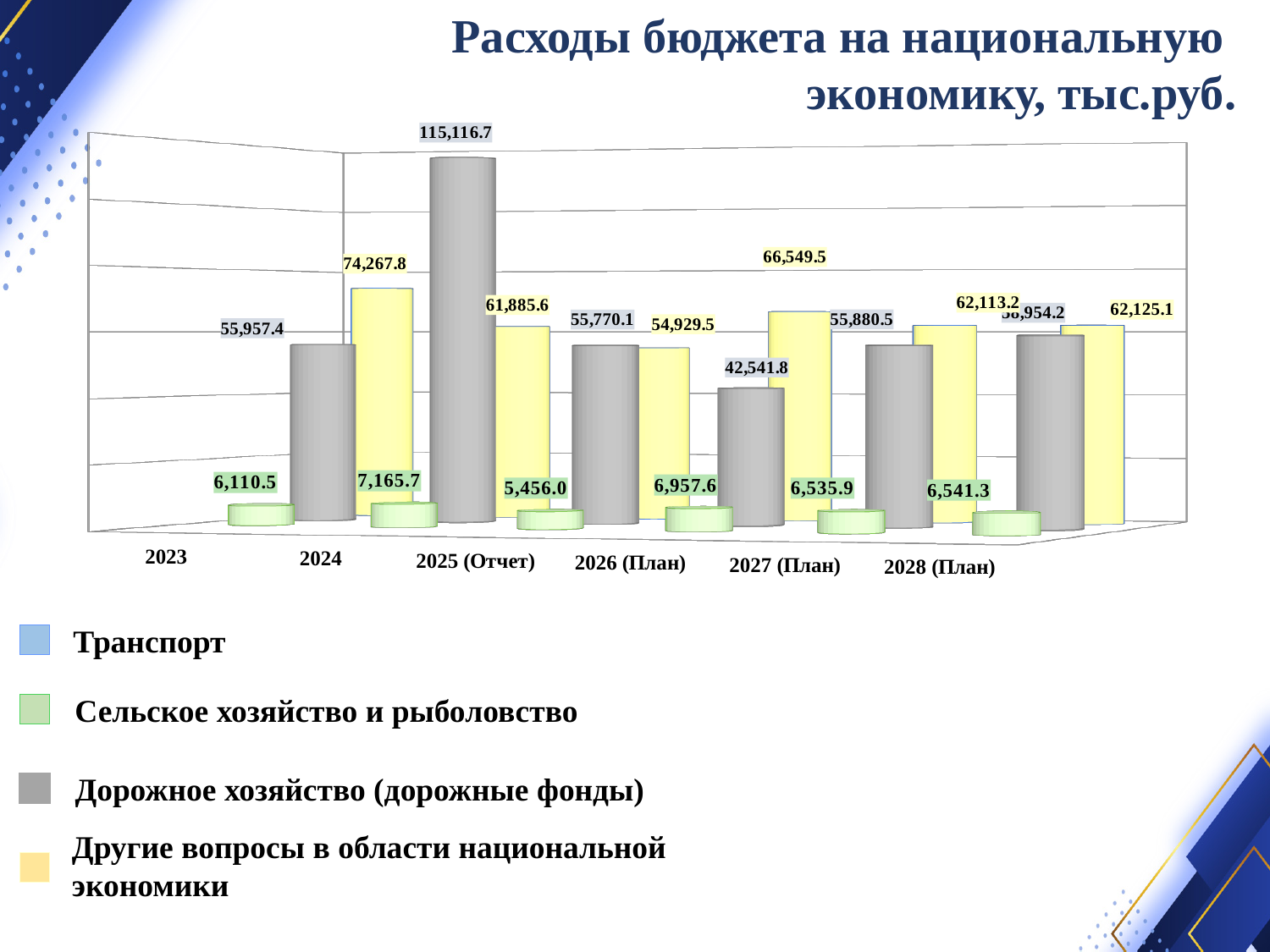
What is the value for Другие вопросы в области национальной экономики in 2026 (План)? 66,549.5 What is the value for Дорожное хозяйство (дорожные фонды) in 2024? 115,116.7 What is the value for Сельское хозяйство и рыболовство in 2023? 6,110.5 In which year is Другие вопросы в области национальной экономики highest? 2023 How many year categories are shown on the x axis? 6 What is the title of the chart? Расходы бюджета на национальную экономику, тыс.руб. How many series does the legend list? 4 In which year is Дорожное хозяйство (дорожные фонды) highest? 2024 What is the difference between Дорожное хозяйство (дорожные фонды) in 2024 and in 2023? 59,159.3 In 2023, which is larger: Дорожное хозяйство (дорожные фонды) or Другие вопросы в области национальной экономики? Другие вопросы в области национальной экономики What kind of chart is shown on the slide? bar chart In which year is Сельское хозяйство и рыболовство lowest? 2025 (Отчет)